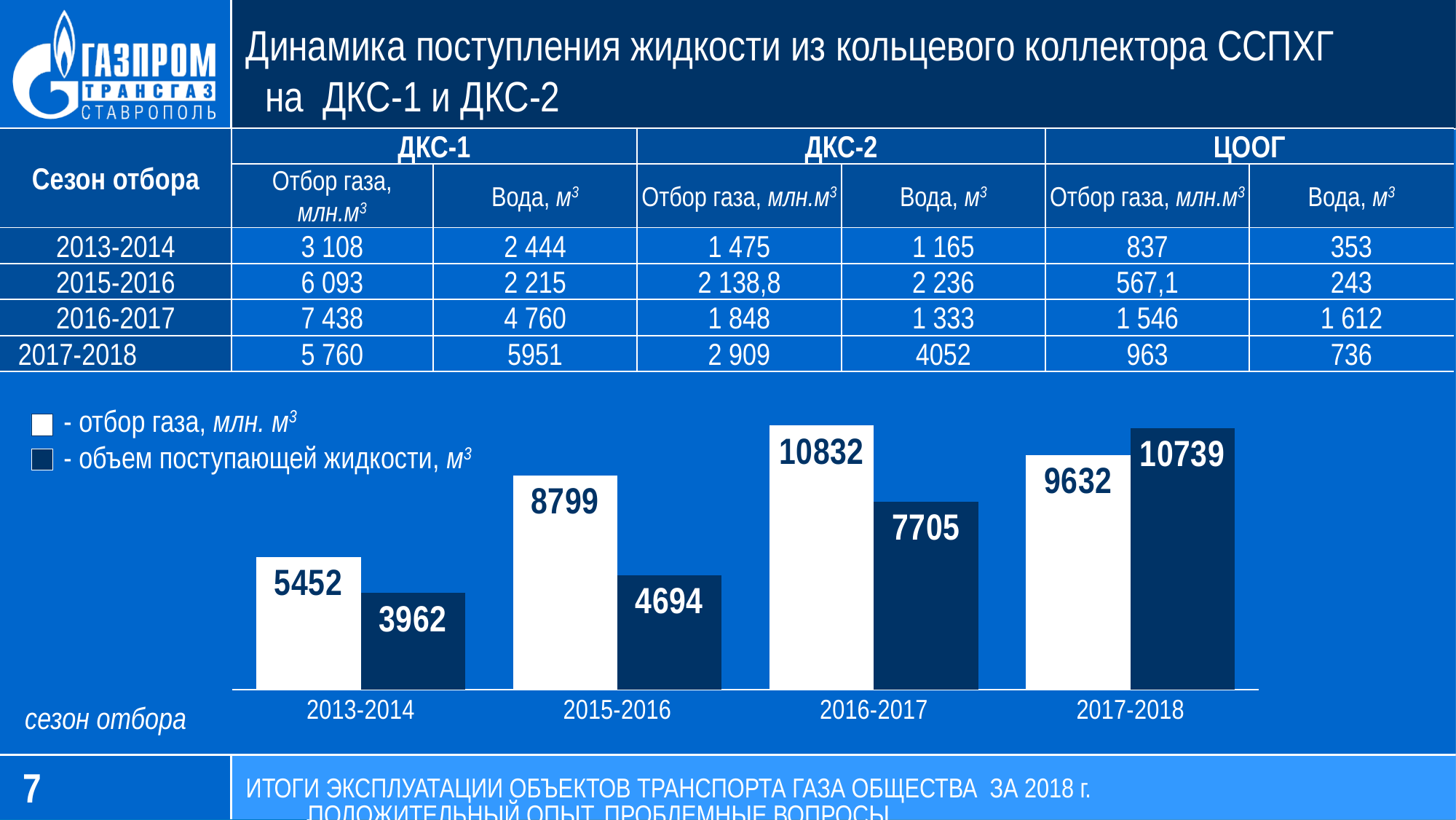
Which season has the lowest value of объем поступающей жидкости in the bar chart? 2013-2014 Which colour represents отбор газа in the bar chart legend? white Which season has the highest value of отбор газа in the bar chart? 2016-2017 In the bar chart, which is larger for the 2017-2018 season: отбор газа or объем поступающей жидкости? объем поступающей жидкости What is the value of отбор газа for the 2013-2014 season in the bar chart? 5452 What is the difference between отбор газа and объем поступающей жидкости for the 2016-2017 season in the bar chart? 3127 How many series does the legend of the bar chart list? 2 What kind of chart is shown at the bottom of the slide? bar chart How many seasons are shown on the x axis of the bar chart? 4 What is the value of объем поступающей жидкости for the 2017-2018 season in the bar chart? 10739 What is the value of объем поступающей жидкости for the 2015-2016 season in the bar chart? 4694 Does the объем поступающей жидкости series rise or fall from 2013-2014 to 2017-2018 in the bar chart? rise